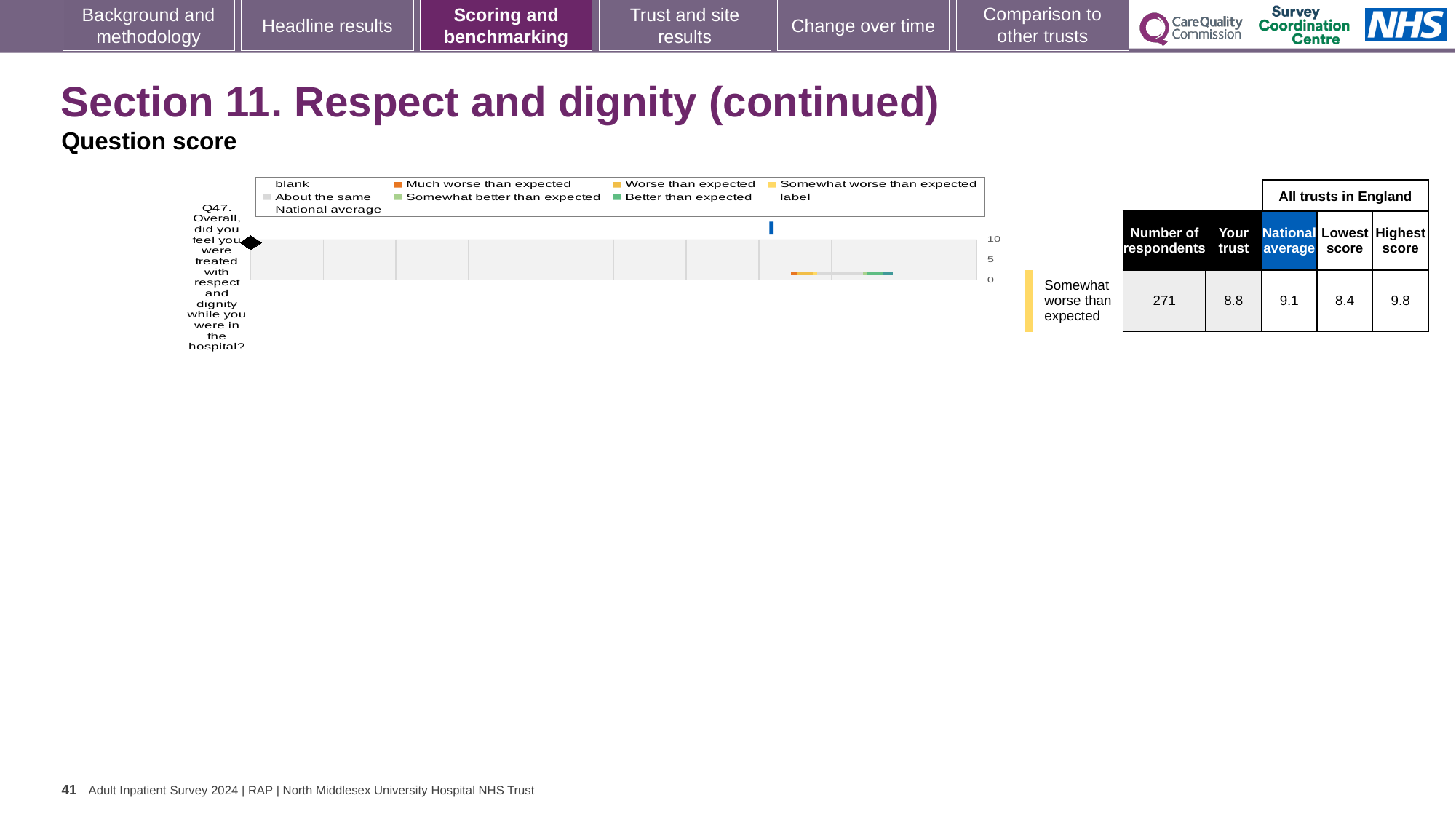
What is the highest score among all trusts in England for Q47? 9.8 What kind of chart is shown on the slide? bar chart What is the 'Your trust' score for Q47 shown in the table? 8.8 What is the lowest score among all trusts in England for Q47? 8.4 Which benchmark category is Q47 assigned to on the slide? Somewhat worse than expected How many survey questions are plotted in the chart? 1 How many respondents are listed for Q47 in the table? 271 Is the 'Your trust' score for Q47 greater or less than 5? greater What is the difference between the highest score and the lowest score for Q47? 1.4 What is the national average score for Q47 shown in the table? 9.1 Which is larger for Q47: the 'Your trust' score or the national average? National average Which question number is plotted in the chart? Q47